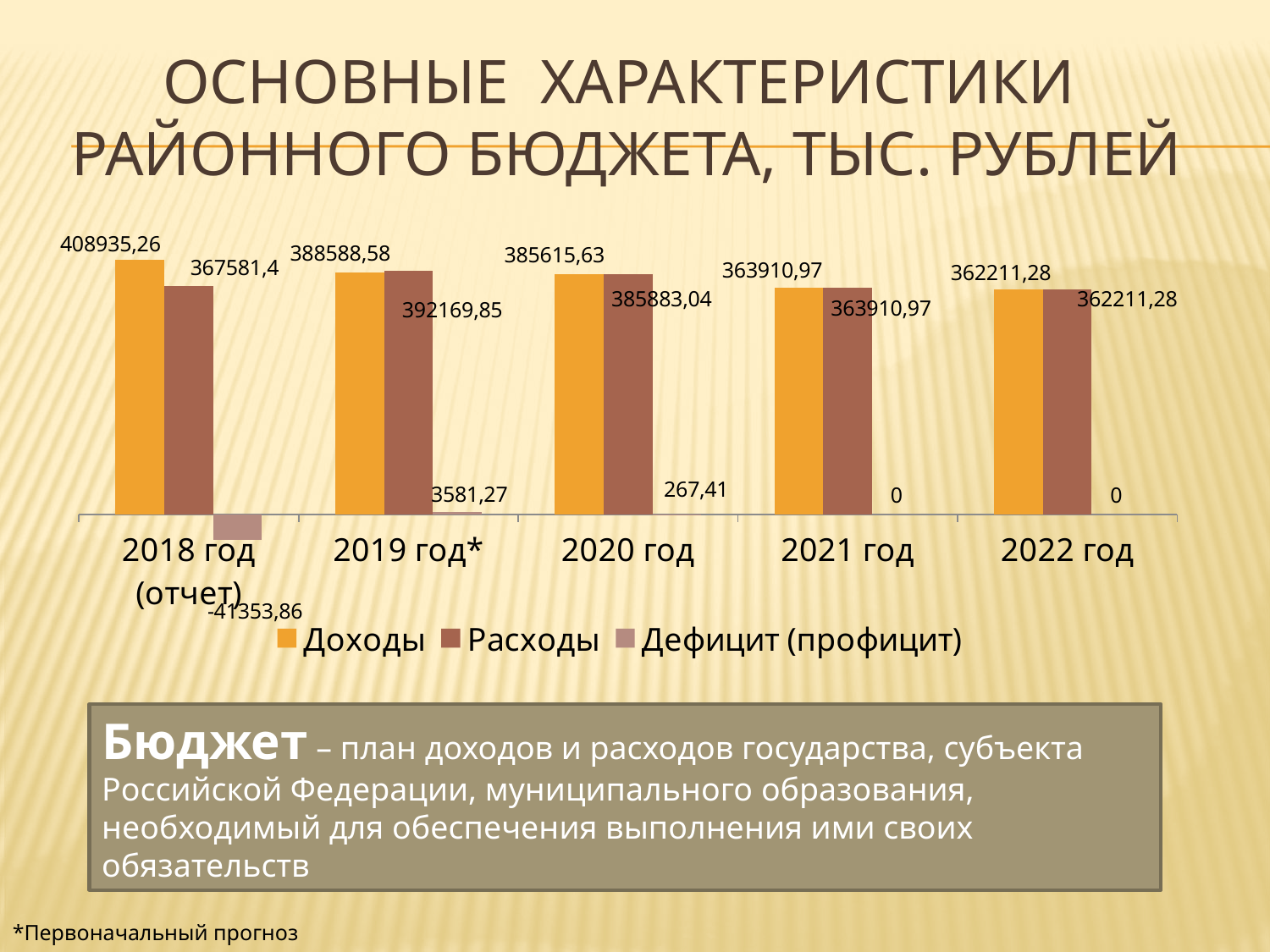
What is the value of Дефицит (профицит) for 2020 год? 267,41 What is the difference between Доходы and Расходы for 2018 год (отчет)? 41353,86 What is the value of Доходы for 2018 год (отчет)? 408935,26 What type of chart is shown on the slide? bar chart In which year is Доходы the lowest? 2022 год What is the value of Расходы for 2019 год*? 392169,85 In which year is Доходы the highest? 2018 год (отчет) How many year categories are shown on the x axis? 5 What is the value of Дефицит (профицит) for 2018 год (отчет)? -41353,86 For 2019 год*, which is larger: Доходы or Расходы? Расходы How many series does the legend list? 3 Do the Доходы values rise or fall from 2018 год (отчет) to 2022 год? fall